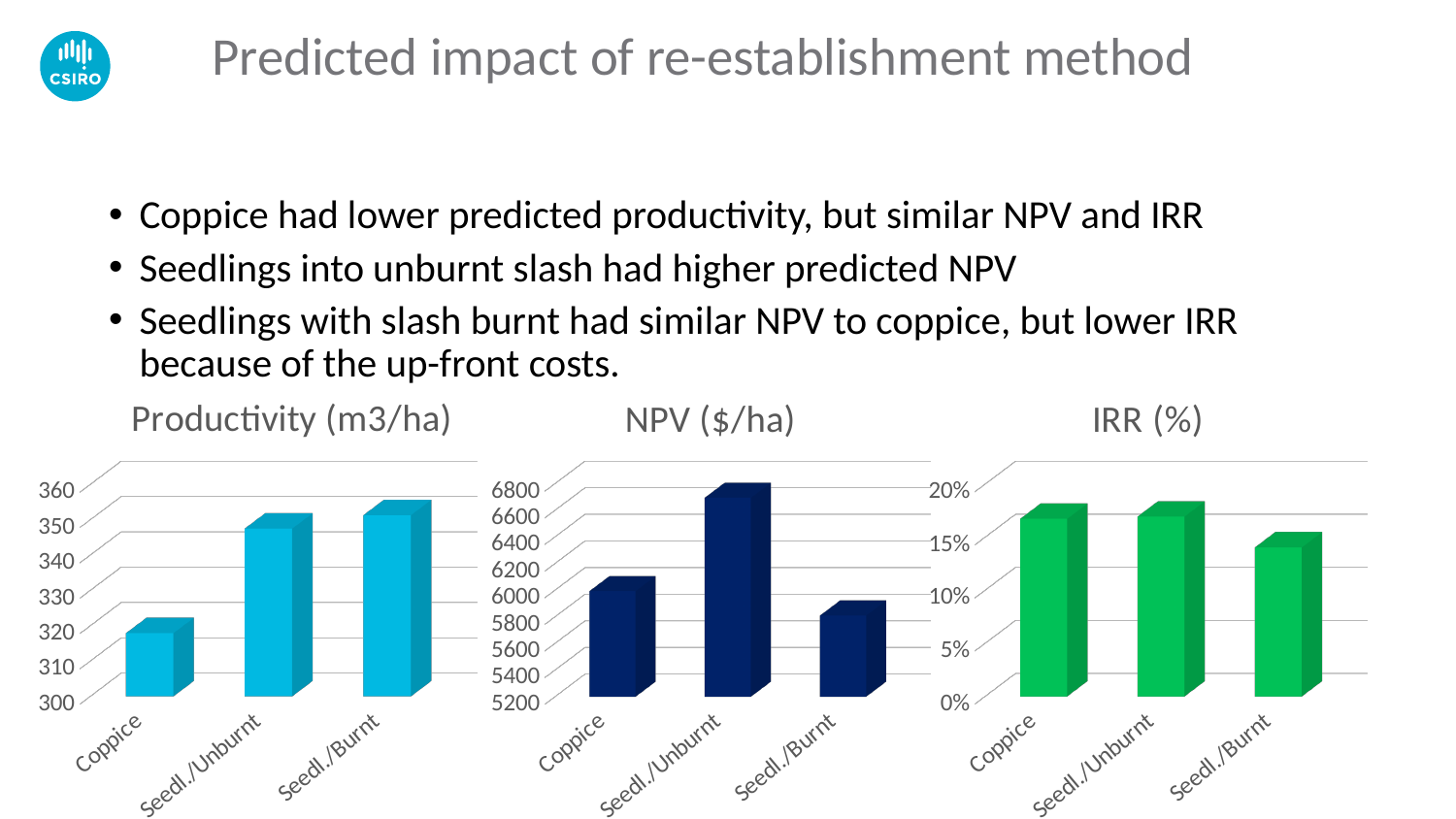
How many categories are shown in the NPV ($/ha) chart? 3 In the NPV ($/ha) chart, is the value for Seedl./Burnt greater or less than 6000? less In the NPV ($/ha) chart, which category has the highest value? Seedl./Unburnt What type of chart is the Productivity (m3/ha) chart? bar chart In the IRR (%) chart, which category has the lowest value? Seedl./Burnt In the Productivity (m3/ha) chart, is the value for Coppice greater or less than 310? greater In the NPV ($/ha) chart, is the value for Seedl./Unburnt greater or less than 6400? greater In the NPV ($/ha) chart, which is larger, the value for Coppice or the value for Seedl./Burnt? Coppice In the Productivity (m3/ha) chart, which category has the lowest value? Coppice In the NPV ($/ha) chart, which category has the lowest value? Seedl./Burnt